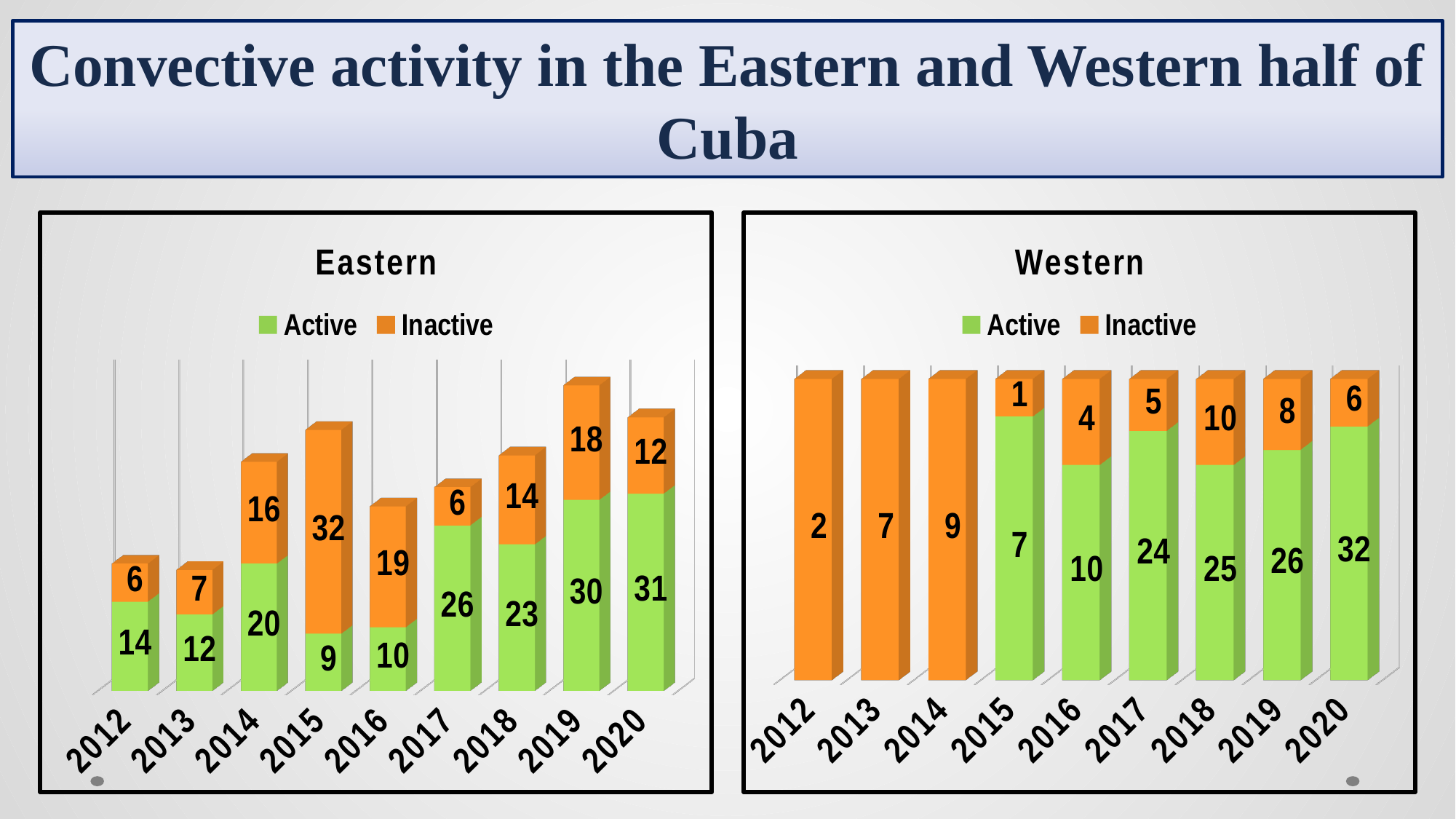
In the Eastern chart, what is the difference between the Inactive values for 2015 and 2016? 13 In the Eastern chart, what is the Active value for 2019? 30 How many years are shown on the x axis of the Western chart? 9 In the Western chart, what is the Active value for 2017? 24 How many series does the legend of the Eastern chart list? 2 In the Western chart, what is the Inactive value for 2018? 10 In the Eastern chart, which year has the lowest Active value? 2015 In the Eastern chart, what is the Inactive value for 2015? 32 In the Western chart, what is the total of the stacked bar for 2020? 38 In the Eastern chart, which year has the highest Active value? 2020 In the Eastern chart, what is the total of the stacked bar for 2019? 48 In the Western chart, which is larger, the Active value for 2016 or the Active value for 2018? 2018